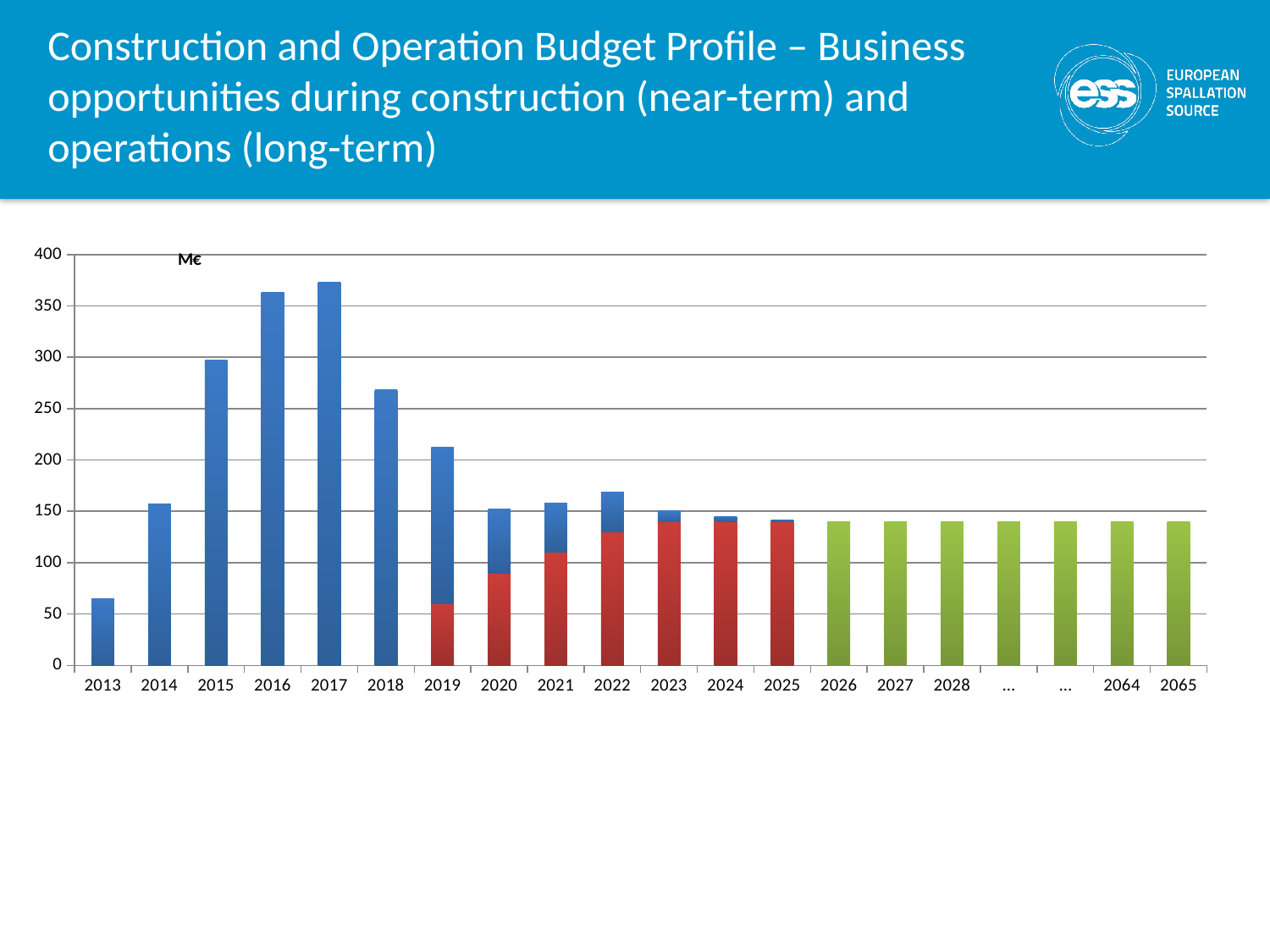
Is the value for 2013 greater or less than 100? less How many categories are shown along the x axis? 20 Is the value for 2026 greater or less than 150? less Which is larger, the bar for 2015 or the bar for 2018? 2015 Is the value for 2016 greater or less than 350? greater Which year has the tallest bar? 2017 What kind of chart is shown on the slide? stacked bar chart What unit label is shown at the top of the chart? M€ Which year has the shortest bar? 2013 Do the bar values rise or fall from 2017 to 2025? fall